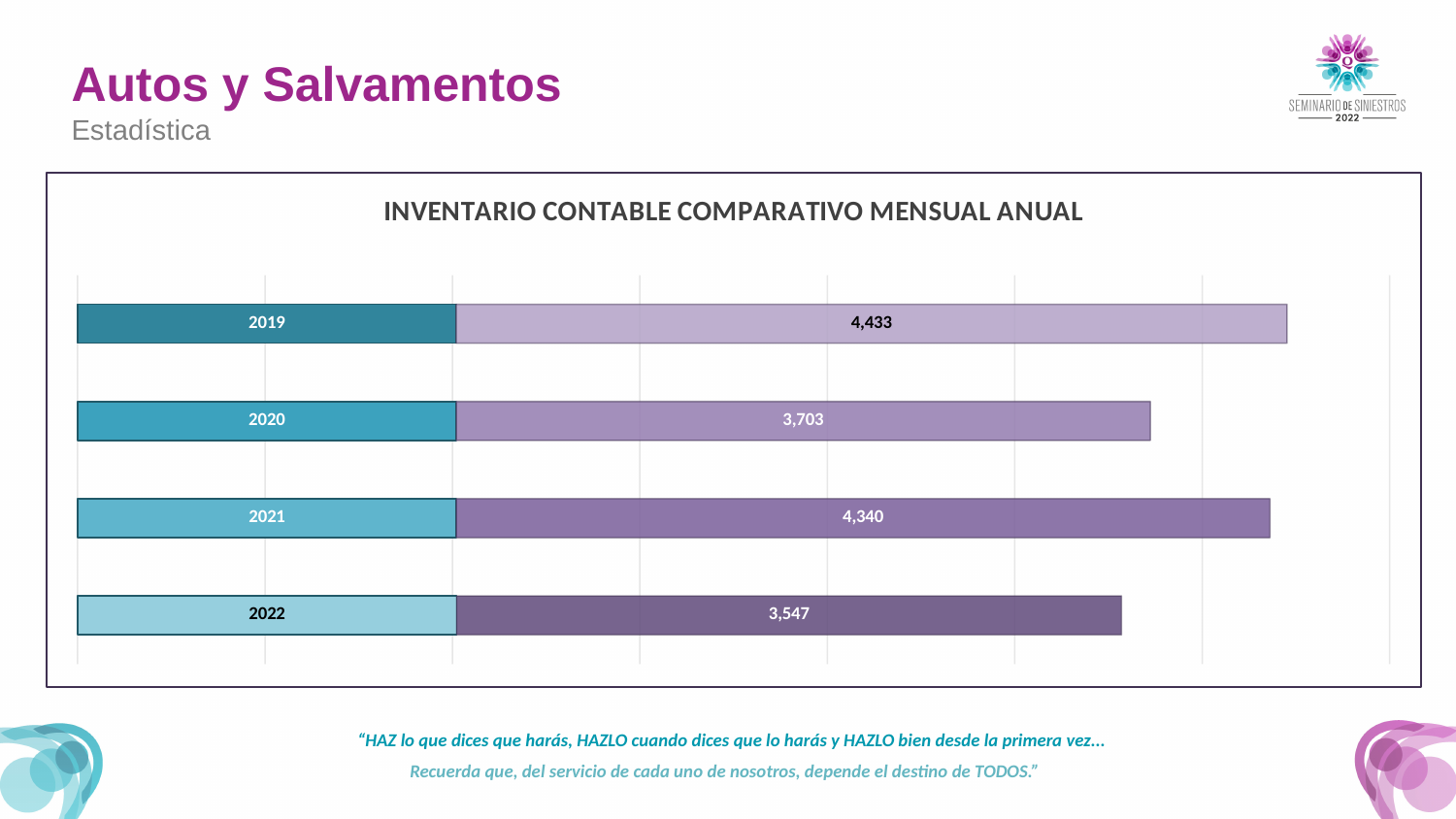
What is the difference between the values for 2019 and 2022? 886 What is the value for 2022? 3,547 What is the title of the chart? INVENTARIO CONTABLE COMPARATIVO MENSUAL ANUAL What is the difference between the values for 2021 and 2020? 637 What kind of chart is shown on the slide? Bar chart What is the value for 2021? 4,340 What is the value for 2019? 4,433 How many years are shown in the chart? 4 Which year has the highest value? 2019 Which year has the lowest value? 2022 Which is larger, the value for 2020 or the value for 2021? 2021 What is the value for 2020? 3,703